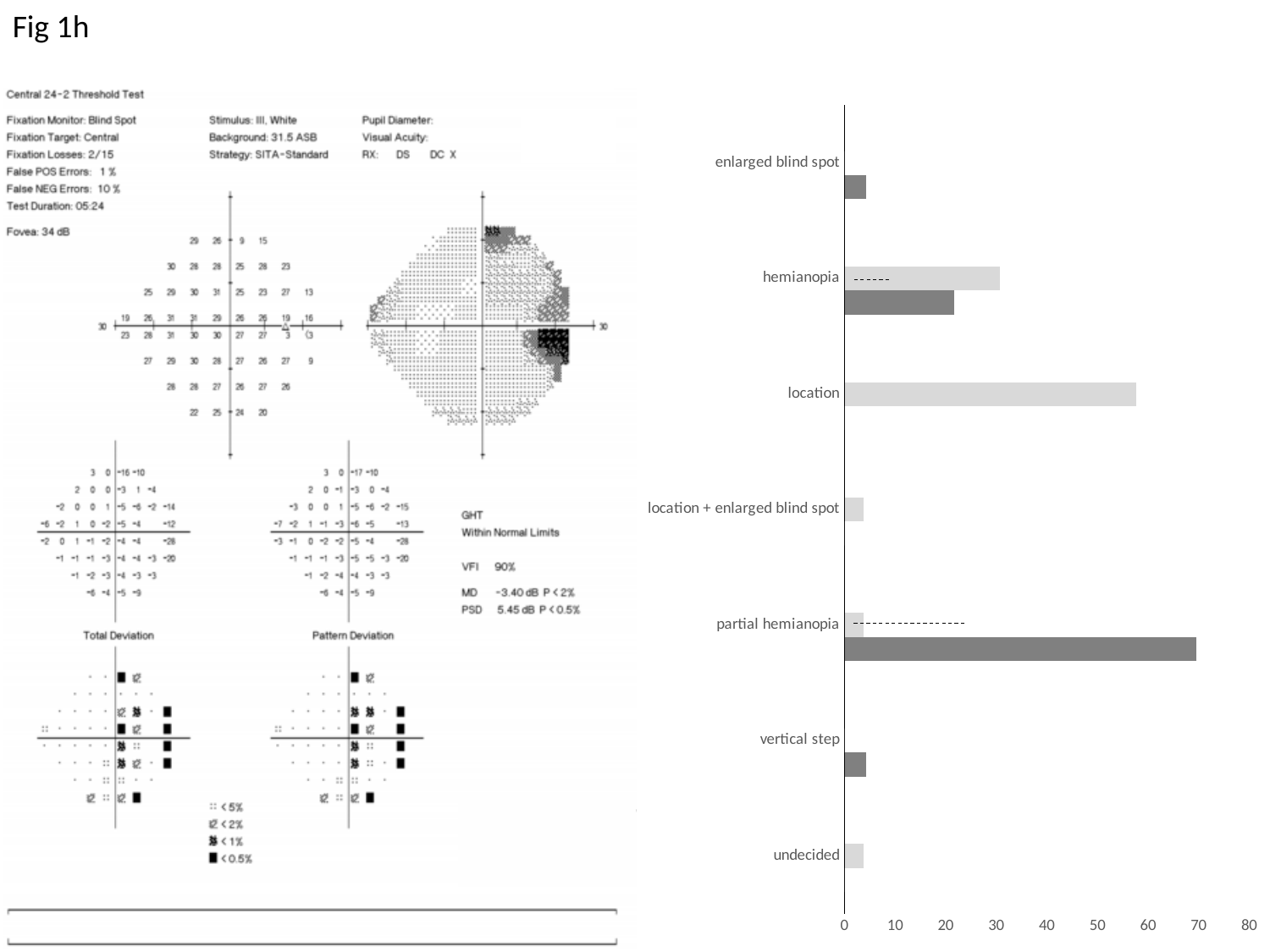
Is the bar for undecided greater or less than 10? less What is the highest value shown on the horizontal axis of the bar chart? 80 Which category has the longest bar in the bar chart? partial hemianopia What kind of chart is shown on the right side of the slide? bar chart Is the light grey bar for hemianopia greater or less than 40? less Which is larger for hemianopia: the light grey bar or the dark grey bar? the light grey bar Is the light grey bar for location greater or less than 50? greater How many categories are listed on the vertical axis of the bar chart? 7 Which is larger in the bar chart: the dark grey bar for partial hemianopia or the light grey bar for location? partial hemianopia Which is larger in the bar chart: the light grey bar for location or the light grey bar for hemianopia? location